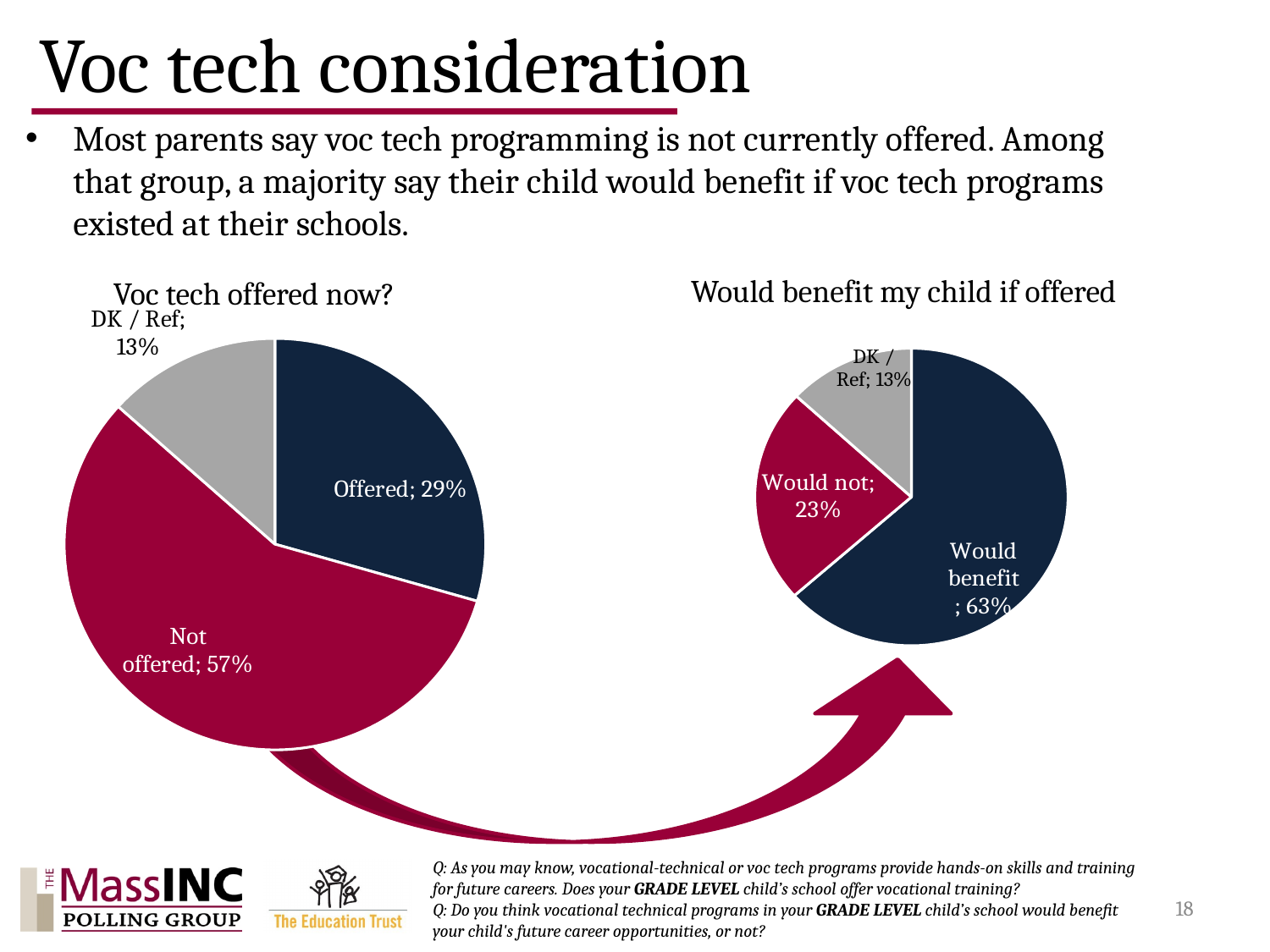
In the 'Would benefit my child if offered' chart, what is the difference between 'Would benefit' and 'Would not'? 40 percentage points In the 'Would benefit my child if offered' chart, which category has the smallest slice? DK / Ref In the 'Voc tech offered now?' chart, what percentage of parents say voc tech is offered? 29% What is the DK / Ref percentage in the 'Voc tech offered now?' chart? 13% In the 'Voc tech offered now?' chart, which category has the largest slice? Not offered In the 'Would benefit my child if offered' chart, what share say their child would benefit? 63% In the 'Would benefit my child if offered' chart, what share say their child would not benefit? 23% In the 'Voc tech offered now?' chart, what is the difference between the 'Not offered' and 'Offered' percentages? 28 percentage points What type of chart is used for 'Would benefit my child if offered'? Pie chart How many slices does the 'Voc tech offered now?' chart have? 3 In the 'Voc tech offered now?' chart, what percentage of parents say voc tech is not offered? 57% In the 'Would benefit my child if offered' chart, which is larger: 'Would not' or 'DK / Ref'? Would not